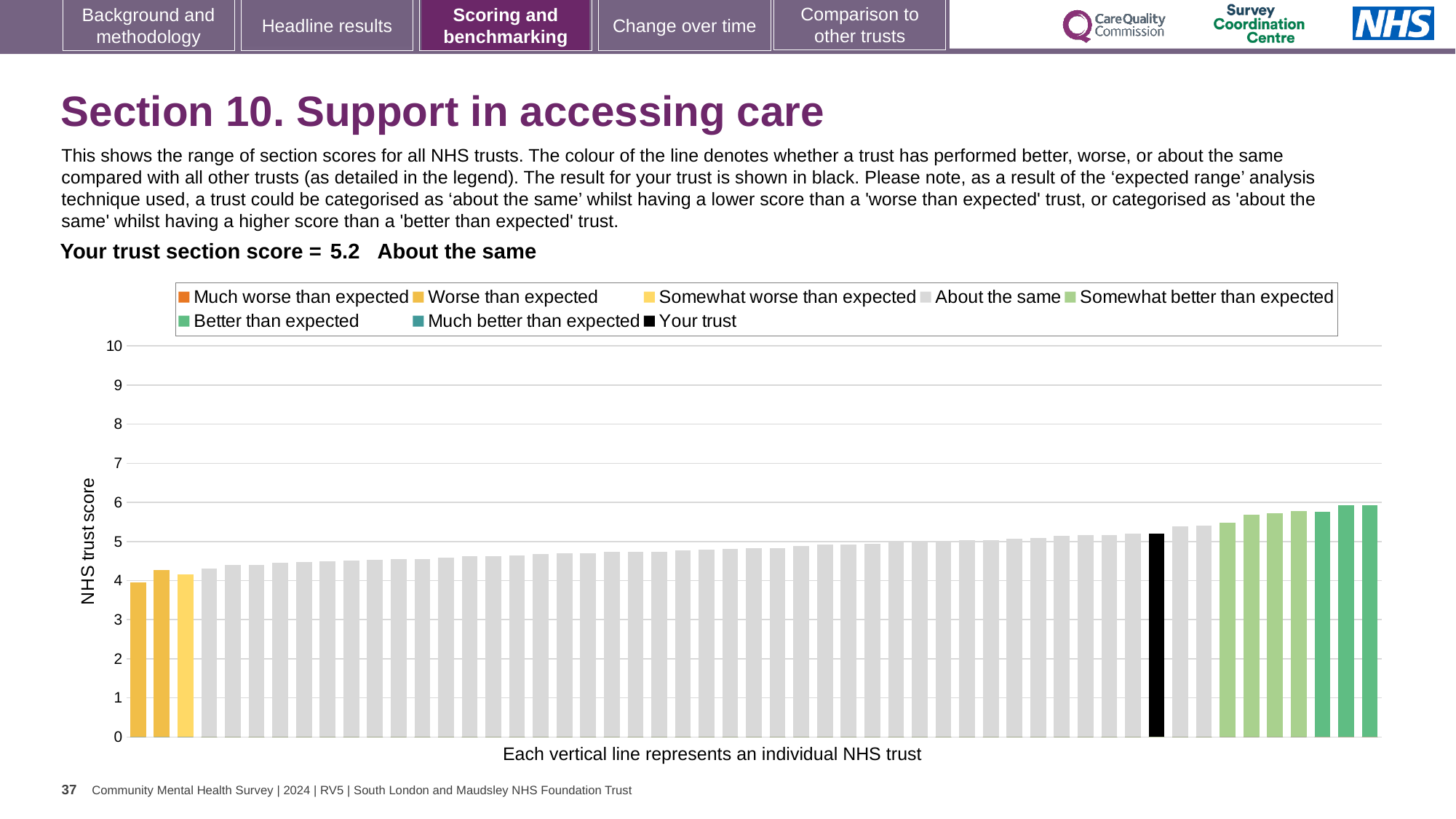
What is the section score for your trust shown on the slide? 5.2 Do the bar heights rise or fall from left to right along the x axis? rise Which performance category is your trust placed in for Section 10? About the same Is the value for your trust (the black bar) greater or less than 6? less How many bars are coloured as 'Much better than expected'? 0 What is the label on the y axis of the chart? NHS trust score What kind of chart is shown on the slide? bar chart Is the value of the tallest bar greater or less than 7? less What colour is the bar representing your trust? black Which legend category do the tallest bars on the right of the chart belong to? Better than expected Is the value of the tallest bar greater or less than 5? greater How many entries does the chart legend list? 8